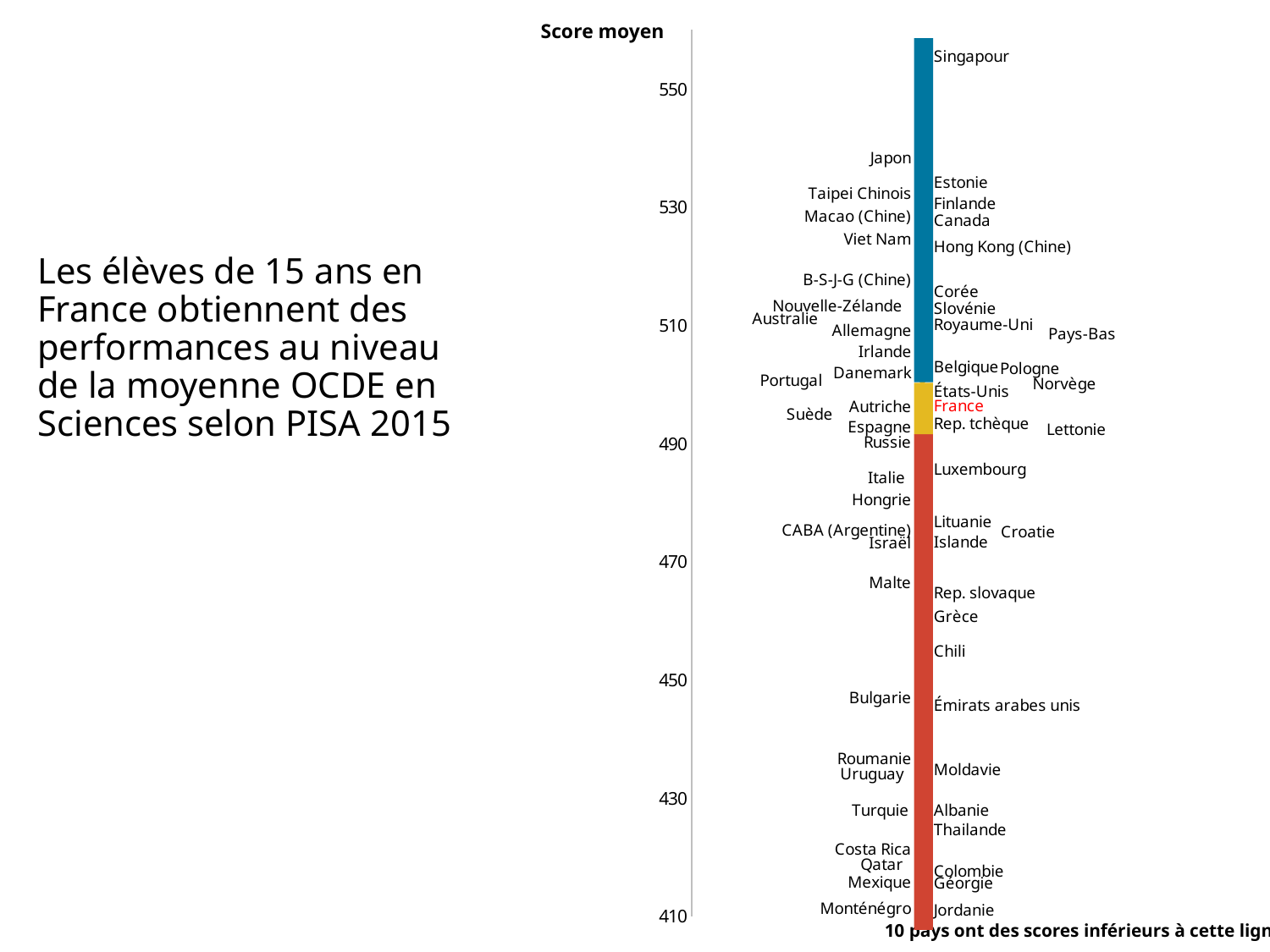
In what colour is the label for France written? Red What is the label of the vertical axis? Score moyen Is the value for Pays-Bas greater or less than 490? greater Which has the higher score, Singapour or Japon? Singapour Which country has the highest score on the chart? Singapour Is the value for Hong Kong (Chine) greater or less than 530? less Is the value for Jordanie greater or less than 430? less